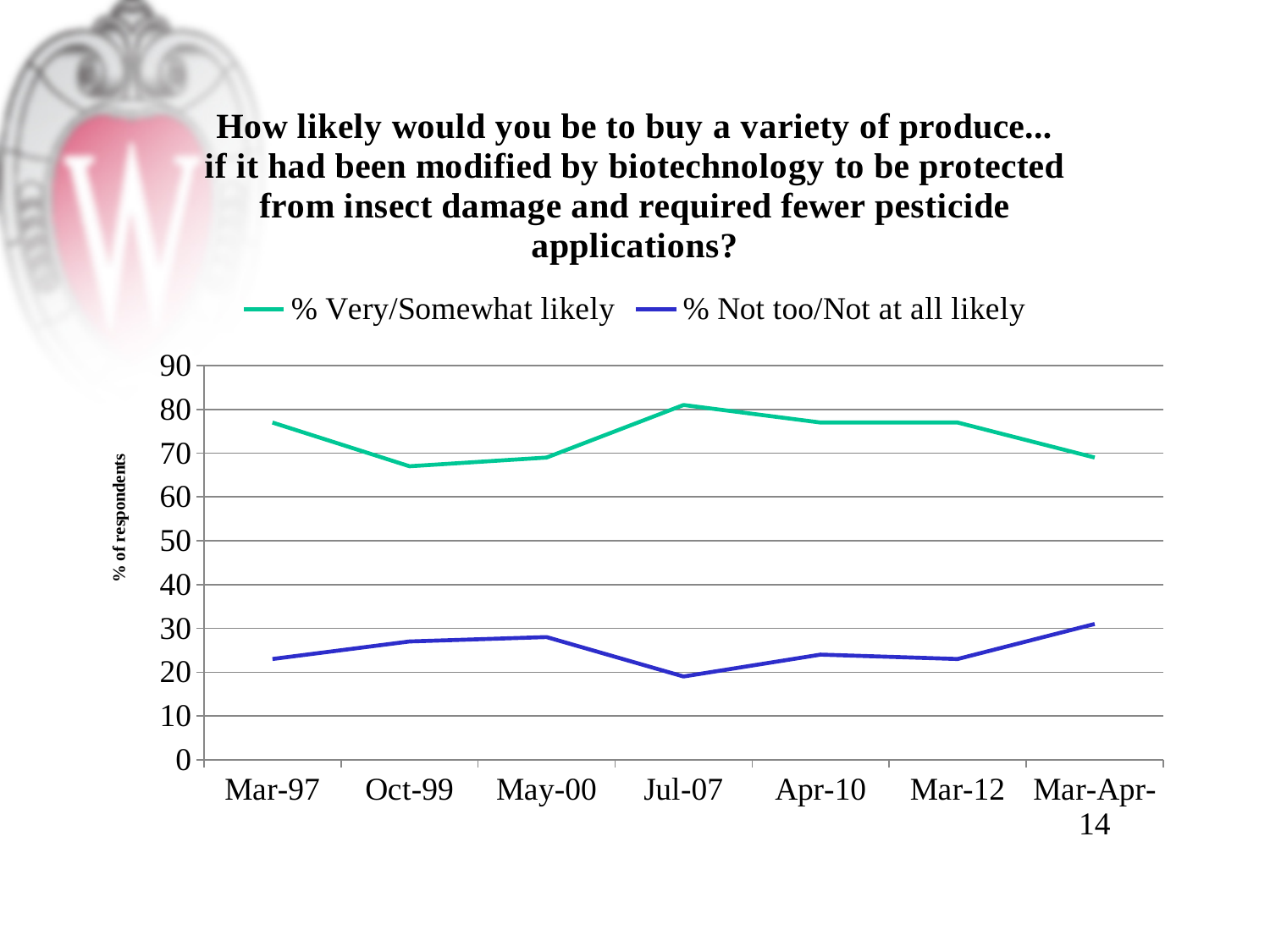
Which series has the larger value at Apr-10, % Very/Somewhat likely or % Not too/Not at all likely? % Very/Somewhat likely Is the value for % Not too/Not at all likely at May-00 greater or less than 20? greater What kind of chart is shown on the slide? line chart At which time point is the % Very/Somewhat likely series highest? Jul-07 Is the value for % Very/Somewhat likely at Mar-97 greater or less than 70? greater How many time points are plotted along the x axis? 7 At which time point is the % Not too/Not at all likely series lowest? Jul-07 Is the value for % Very/Somewhat likely at Oct-99 greater or less than 70? less At which time point is the % Not too/Not at all likely series highest? Mar-Apr-14 How many series does the legend list? 2 Does the % Very/Somewhat likely series rise or fall from Jul-07 to Mar-Apr-14? fall What is the label on the vertical axis? % of respondents